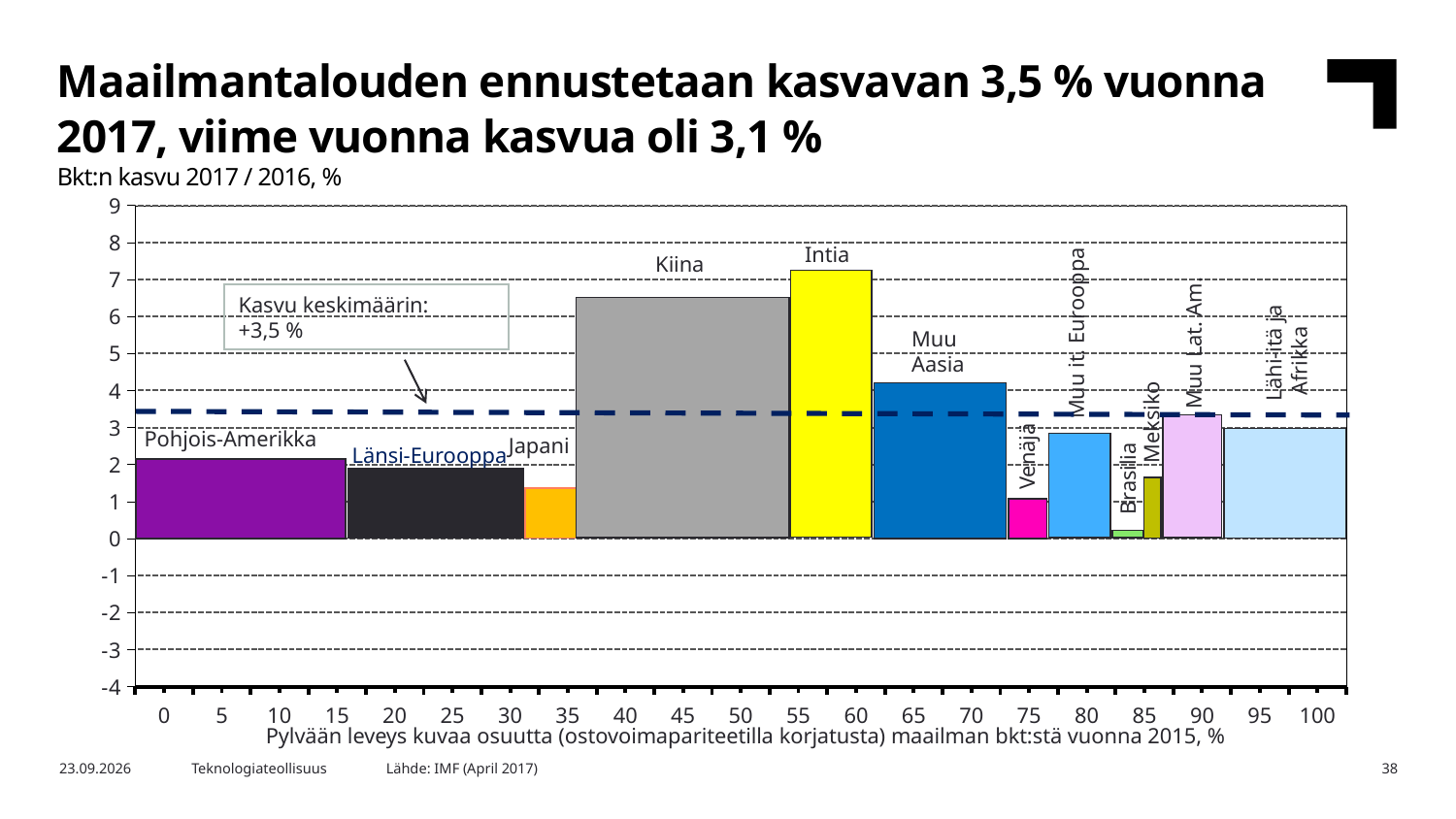
Which region has the highest GDP growth in the chart? Intia Which has the higher GDP growth, Kiina or Japani? Kiina Is the value for Muu Aasia greater or less than 3? greater Which region has the lowest GDP growth in the chart? Brasilia How many regions are shown as bars in the chart? 12 Is the value for Brasilia greater or less than 1? less Is the value for Lähi-itä ja Afrikka greater or less than 4? less What average growth value is marked by the dashed line in the chart? +3,5 % Which has the higher GDP growth, Venäjä or Brasilia? Venäjä What kind of chart is shown on the slide? bar chart